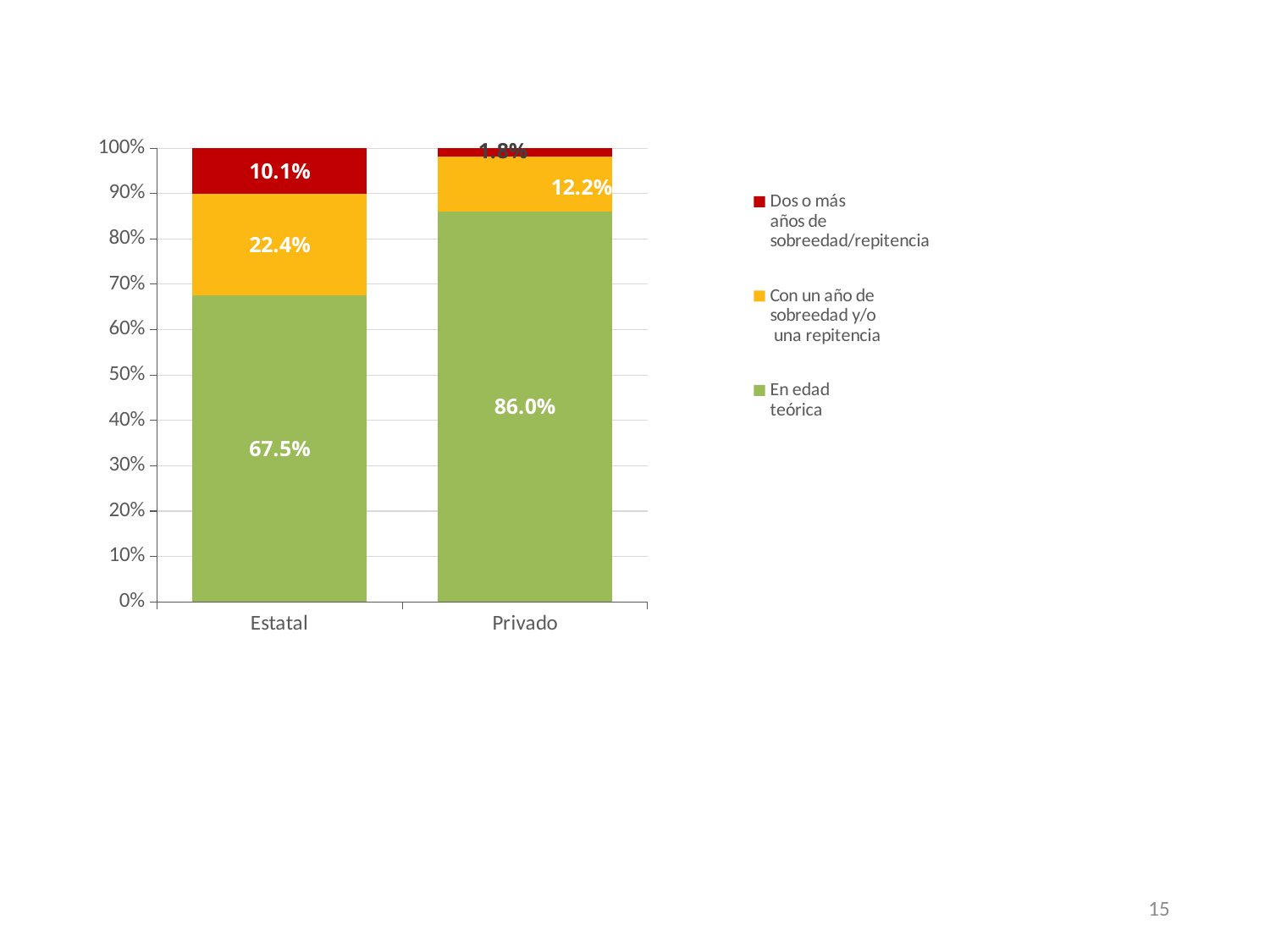
What is the difference between the "Con un año de sobreedad y/o una repitencia" values for Estatal and Privado? 10.2% What is the value for "En edad teórica" in the Estatal bar? 67.5% How many series does the legend list? 3 What is the difference between the "En edad teórica" values for Privado and Estatal? 18.5% What is the value for "En edad teórica" in the Privado bar? 86.0% What is the value for "Con un año de sobreedad y/o una repitencia" in the Estatal bar? 22.4% How many categories are shown on the x axis? 2 What is the value for "Con un año de sobreedad y/o una repitencia" in the Privado bar? 12.2% What kind of chart is shown on the slide? Stacked bar chart Which category has the higher value for "En edad teórica", Estatal or Privado? Privado Which colour represents "En edad teórica" in the chart? Green What is the value for "Dos o más años de sobreedad/repitencia" in the Estatal bar? 10.1%